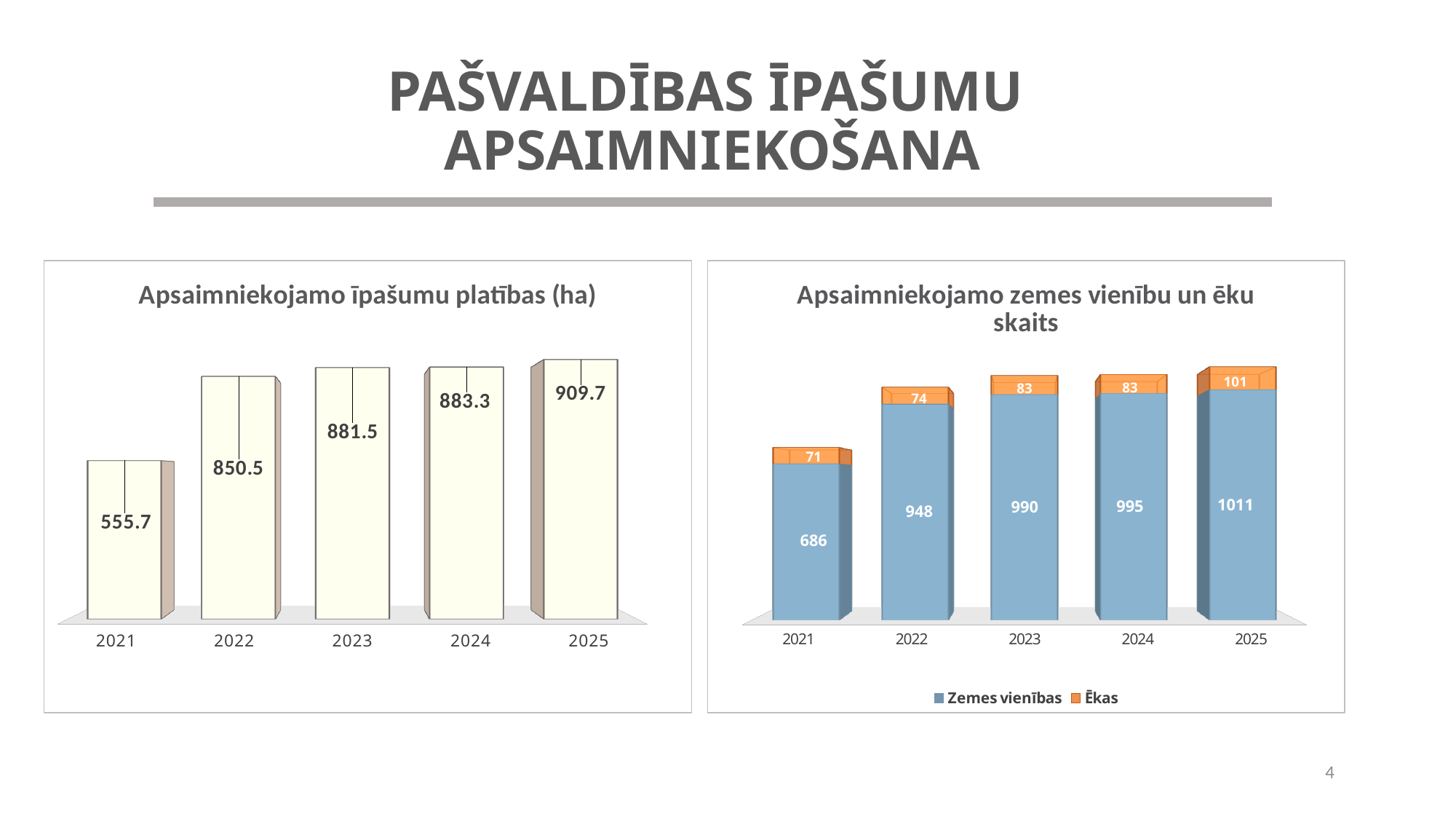
How many series does the legend list in the chart 'Apsaimniekojamo zemes vienību un ēku skaits'? 2 What kind of chart is 'Apsaimniekojamo zemes vienību un ēku skaits'? stacked bar chart In the chart 'Apsaimniekojamo īpašumu platības (ha)', what is the value for 2023? 881.5 How many years are shown in the chart 'Apsaimniekojamo īpašumu platības (ha)'? 5 In the chart 'Apsaimniekojamo īpašumu platības (ha)', which year has the highest value? 2025 In the chart 'Apsaimniekojamo īpašumu platības (ha)', do the values rise or fall from 2021 to 2025? rise In the chart 'Apsaimniekojamo īpašumu platības (ha)', what is the difference between the 2025 and 2021 values? 354 In the chart 'Apsaimniekojamo īpašumu platības (ha)', which year has the lowest value? 2021 In the chart 'Apsaimniekojamo zemes vienību un ēku skaits', what is the value of Ēkas for 2025? 101 In the chart 'Apsaimniekojamo zemes vienību un ēku skaits', what is the value of Zemes vienības for 2022? 948 In the chart 'Apsaimniekojamo zemes vienību un ēku skaits', which is larger: Zemes vienības in 2023 or in 2024? 2024 In the chart 'Apsaimniekojamo zemes vienību un ēku skaits', what is the total of the stacked bar for 2021? 757